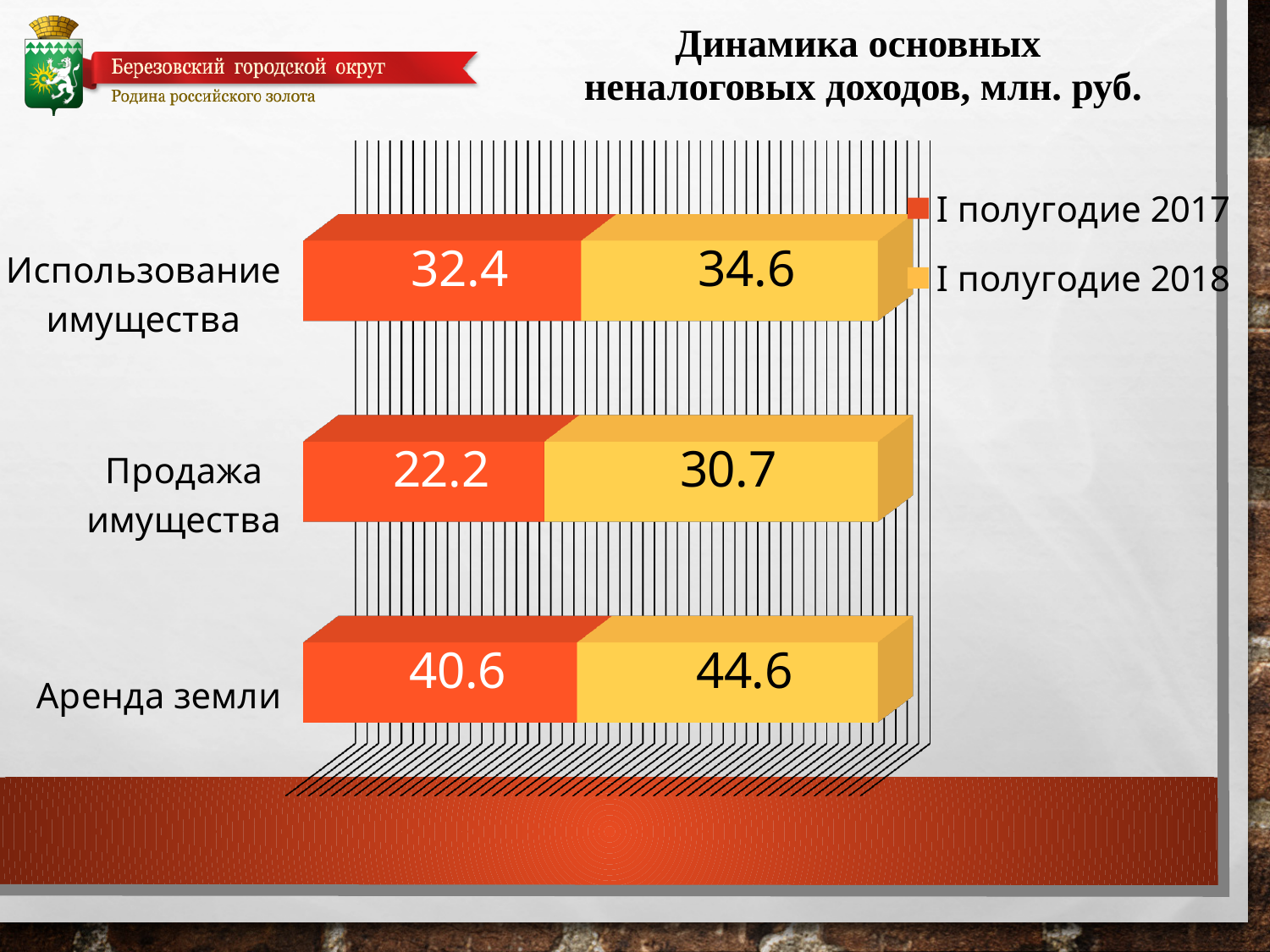
What kind of chart is shown on the slide? Stacked bar chart Which is larger for Использование имущества: the I полугодие 2017 value or the I полугодие 2018 value? I полугодие 2018 What is the total of the stacked bar for Аренда земли? 85.2 What is the value for Продажа имущества in I полугодие 2018? 30.7 What is the value for Использование имущества in I полугодие 2017? 32.4 Which category has the lowest value in I полугодие 2017? Продажа имущества What is the difference between the I полугодие 2018 and I полугодие 2017 values for Продажа имущества? 8.5 How many categories are shown on the chart? 3 How many series does the legend list? 2 Which category has the highest value in I полугодие 2018? Аренда земли What is the difference between the I полугодие 2018 and I полугодие 2017 values for Аренда земли? 4.0 What is the value for Аренда земли in I полугодие 2017? 40.6